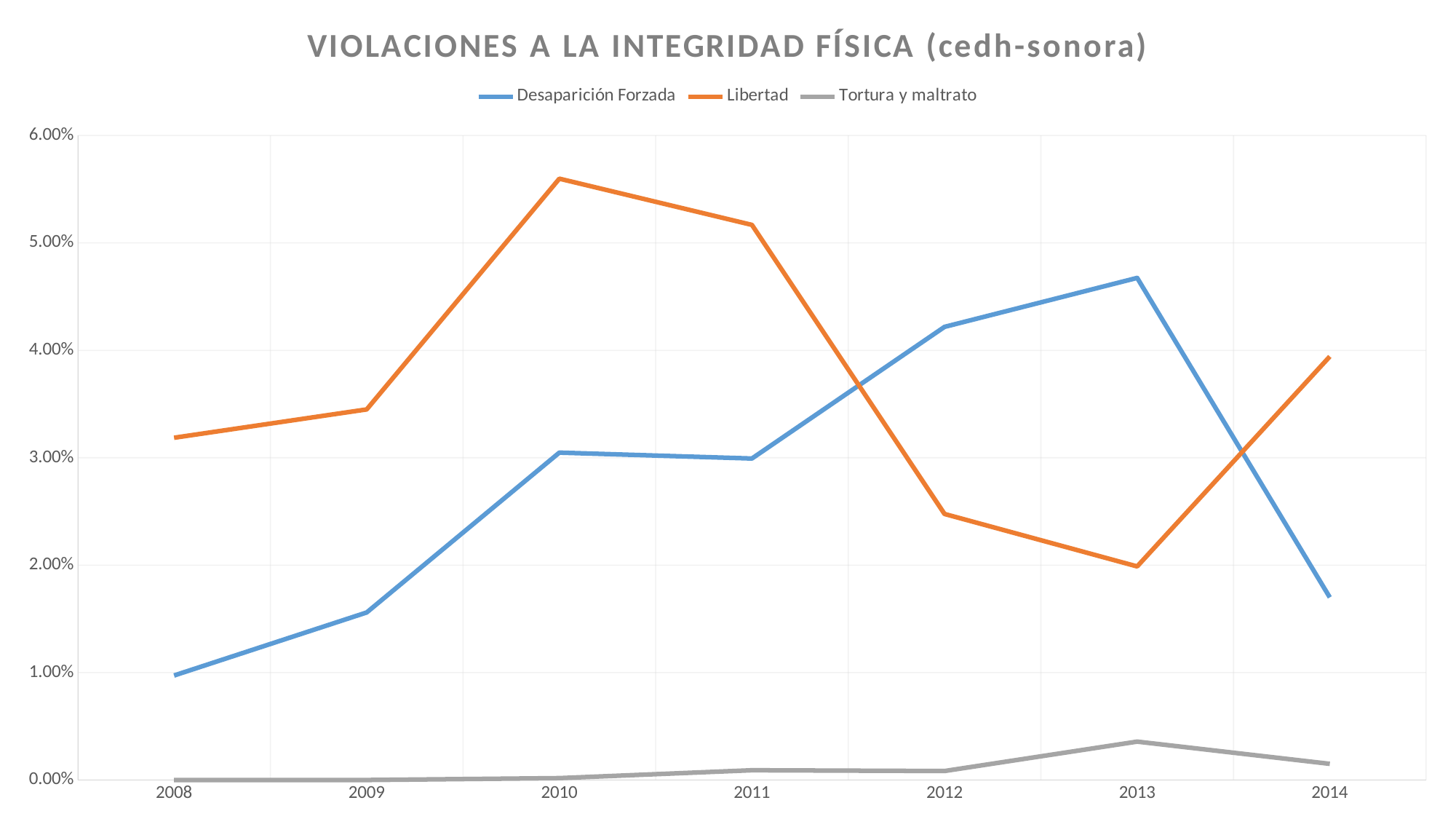
In which year is the Libertad series at its lowest value? 2013 In which year does the Desaparición Forzada series reach its highest value? 2013 How many series does the legend list? 3 In 2014, which is larger: Libertad or Desaparición Forzada? Libertad How many years are plotted along the x axis? 7 In which year does the Libertad series reach its highest value? 2010 Does the Desaparición Forzada series rise or fall from 2008 to 2013? rise Which series has the lowest values across all years? Tortura y maltrato Is the value for Libertad in 2012 greater or less than 3.00%? less What kind of chart is shown on the slide? Line chart Is the value for Libertad in 2010 greater or less than 5.00%? greater In 2012, which is larger: Desaparición Forzada or Libertad? Desaparición Forzada